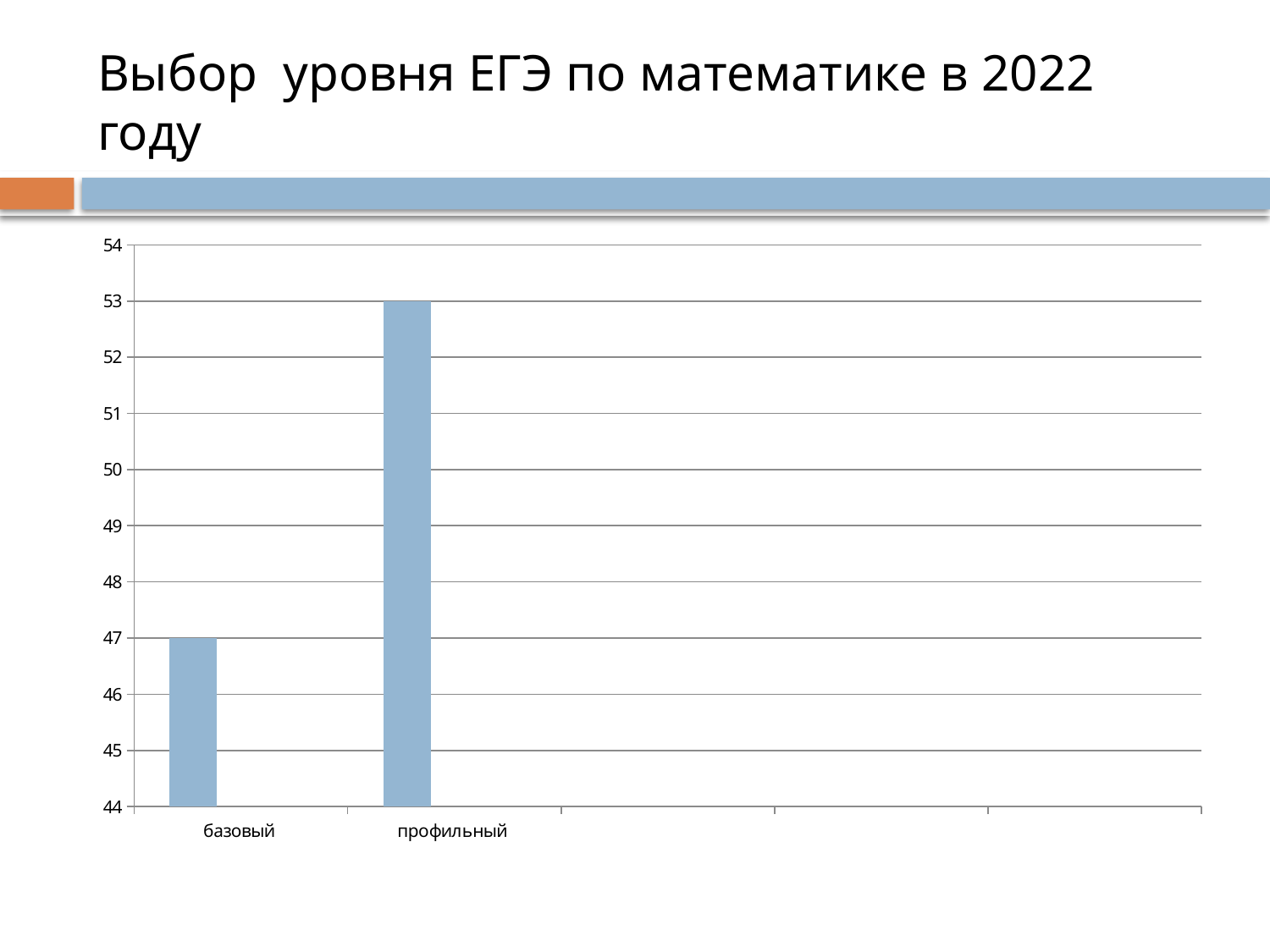
What is the title of the slide containing the chart? Выбор уровня ЕГЭ по математике в 2022 году What is the lowest value shown on the vertical axis of the chart? 44 How many categories are plotted in the chart? 2 What type of chart is shown on the slide? bar chart Which category has the highest value? профильный Which is larger, the value for базовый or the value for профильный? профильный What is the value for профильный? 53 What is the value for базовый? 47 Is the value for профильный greater or less than 50? greater Is the value for базовый greater or less than 50? less Which category has the lowest value? базовый What is the difference between the values for профильный and базовый? 6